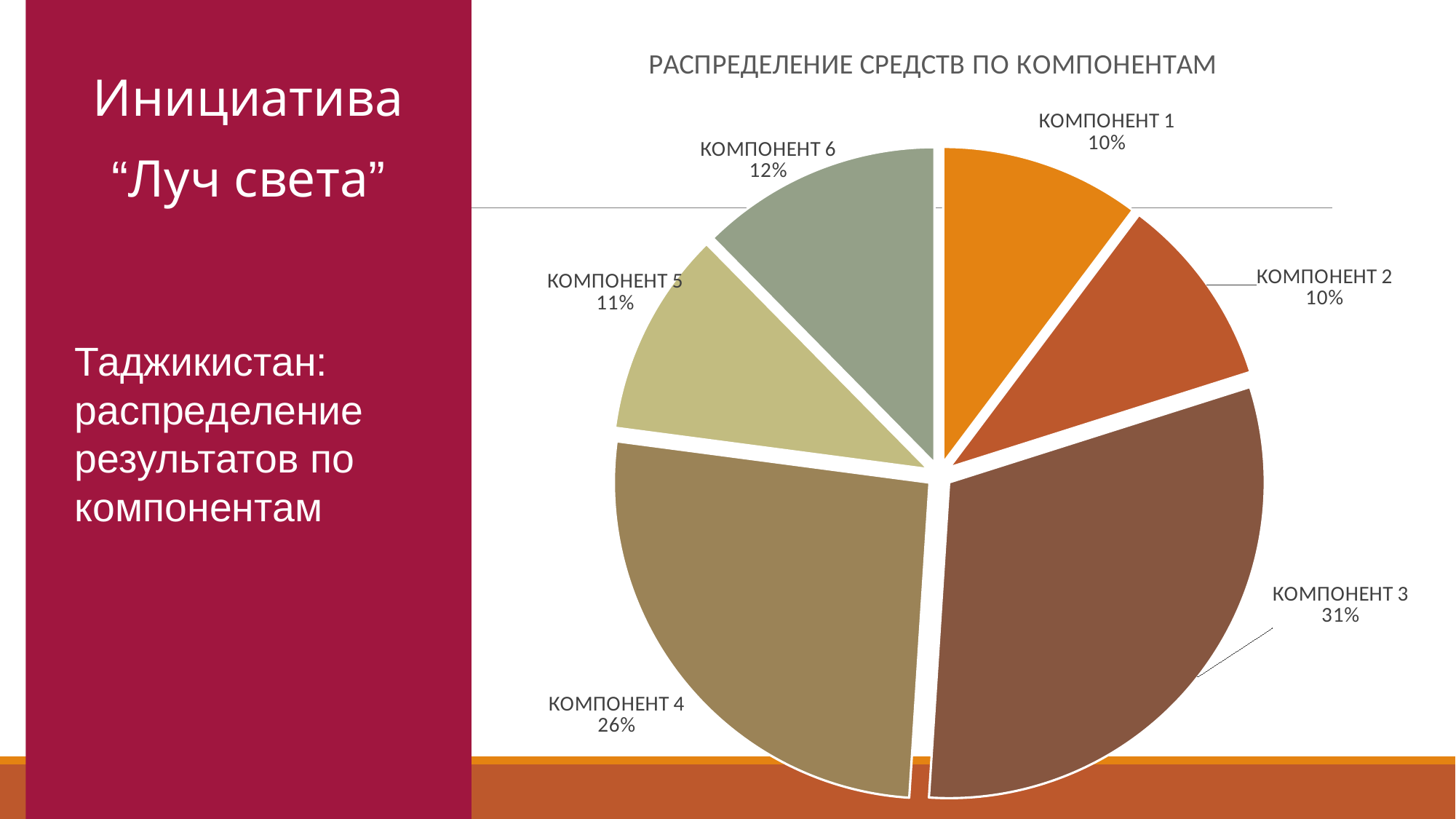
How many slices does the pie chart have? 6 What share of the pie does КОМПОНЕНТ 3 have? 31% What kind of chart is shown on the slide? Pie chart What is the title of the chart? РАСПРЕДЕЛЕНИЕ СРЕДСТВ ПО КОМПОНЕНТАМ Which component has the largest share of the pie? КОМПОНЕНТ 3 What is the value shown for КОМПОНЕНТ 4? 26% What is the difference in percentage points between КОМПОНЕНТ 3 and КОМПОНЕНТ 4? 5% What is the value shown for КОМПОНЕНТ 5? 11% What is the value shown for КОМПОНЕНТ 6? 12% What colour is the slice for КОМПОНЕНТ 1? Orange Which is larger, КОМПОНЕНТ 6 or КОМПОНЕНТ 5? КОМПОНЕНТ 6 What is the combined share of КОМПОНЕНТ 1 and КОМПОНЕНТ 2? 20%